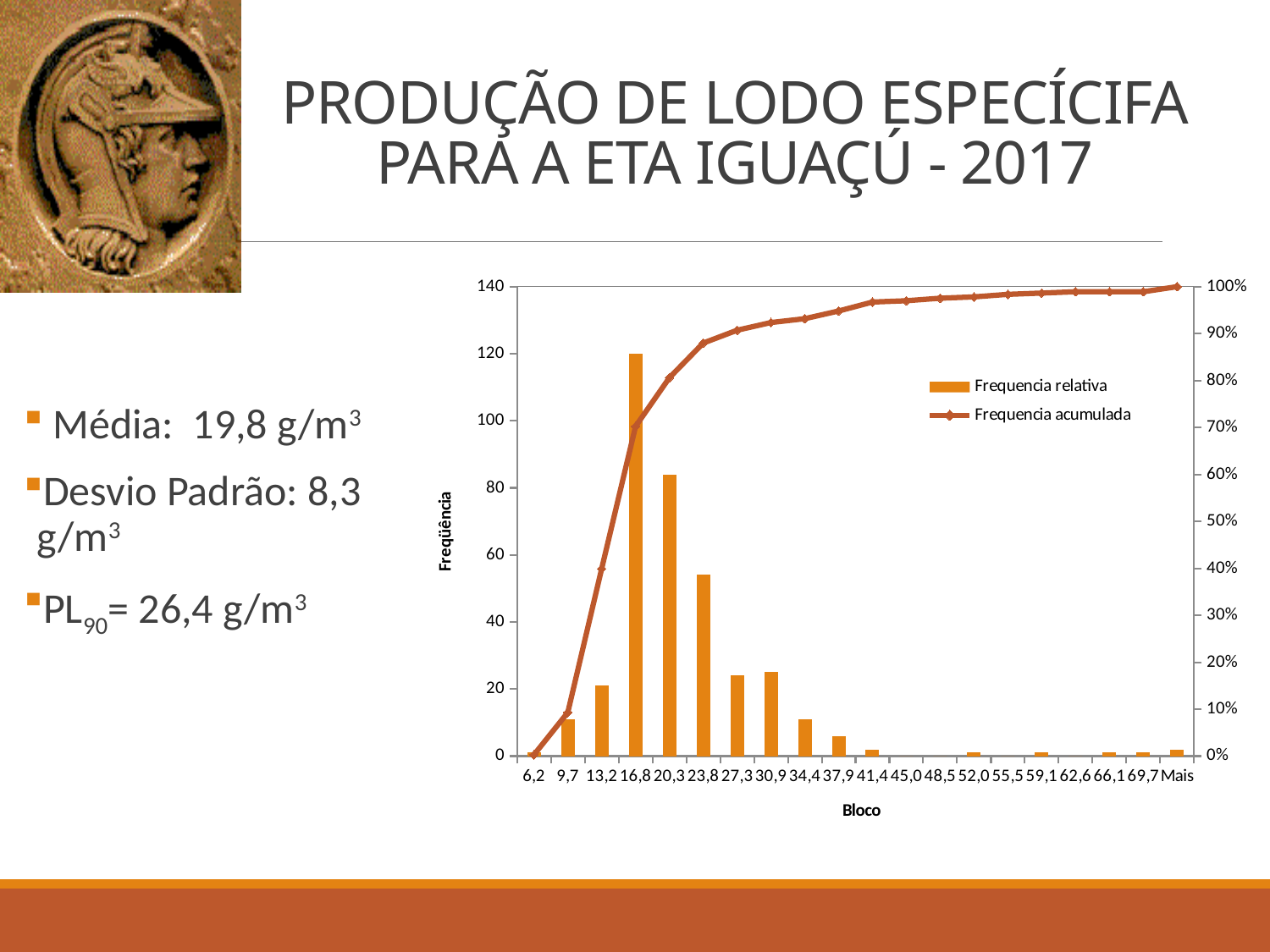
What are the two series named in the chart legend? Frequencia relativa and Frequencia acumulada Is the Frequencia relativa bar for bloco 20,3 greater or less than 60? greater Which bloco has the highest Frequencia relativa bar? 16,8 Which bloco has the larger Frequencia relativa bar, 9,7 or 13,2? 13,2 Does the Frequencia acumulada line rise or fall as you move along the x axis? rise Is the Frequencia relativa bar for bloco 23,8 greater or less than 60? less How many series does the chart legend list? 2 How many categories (blocos) are shown along the x axis of the chart? 20 What kind of chart is shown on the slide? bar chart combined with a line Is the Frequencia relativa bar for bloco 34,4 greater or less than 20? less What is the title of the x axis of the chart? Bloco What is the Frequencia acumulada value at the last category, Mais? 100%